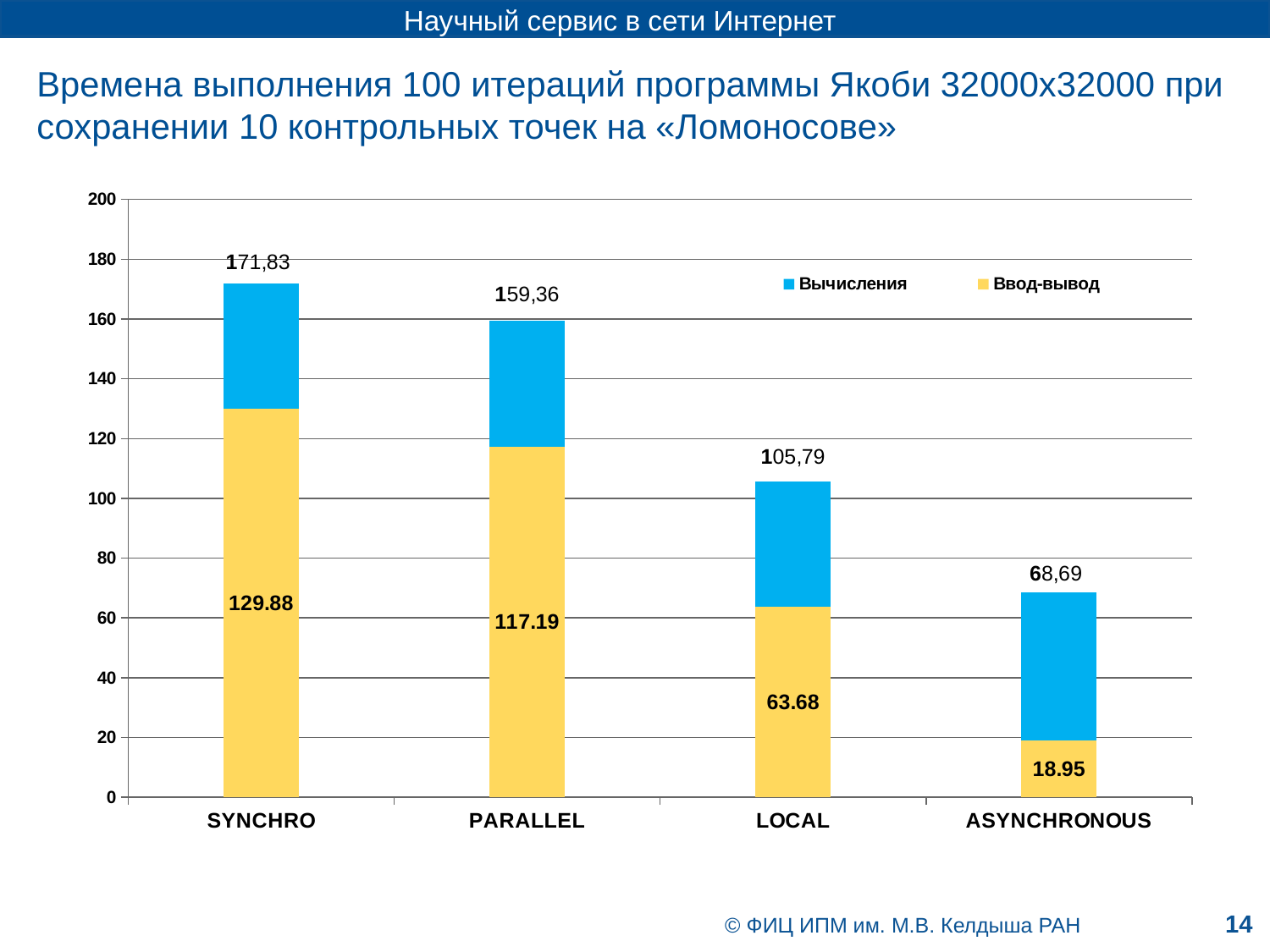
Is the total bar for ASYNCHRONOUS greater or less than 80? less What is the Ввод-вывод value for SYNCHRO? 129.88 Which category has the lowest Ввод-вывод value? ASYNCHRONOUS What is the total of the stacked bar for PARALLEL? 159,36 What is the difference between the Ввод-вывод values for SYNCHRO and ASYNCHRONOUS? 110.93 How many categories are shown on the x axis of the chart? 4 How many series does the chart legend list? 2 What is the Ввод-вывод value for ASYNCHRONOUS? 18.95 Which category has the highest total bar? SYNCHRO What type of chart is shown on the slide? stacked bar chart What is the total of the stacked bar for LOCAL? 105,79 Which series is shown in blue in the chart legend? Вычисления